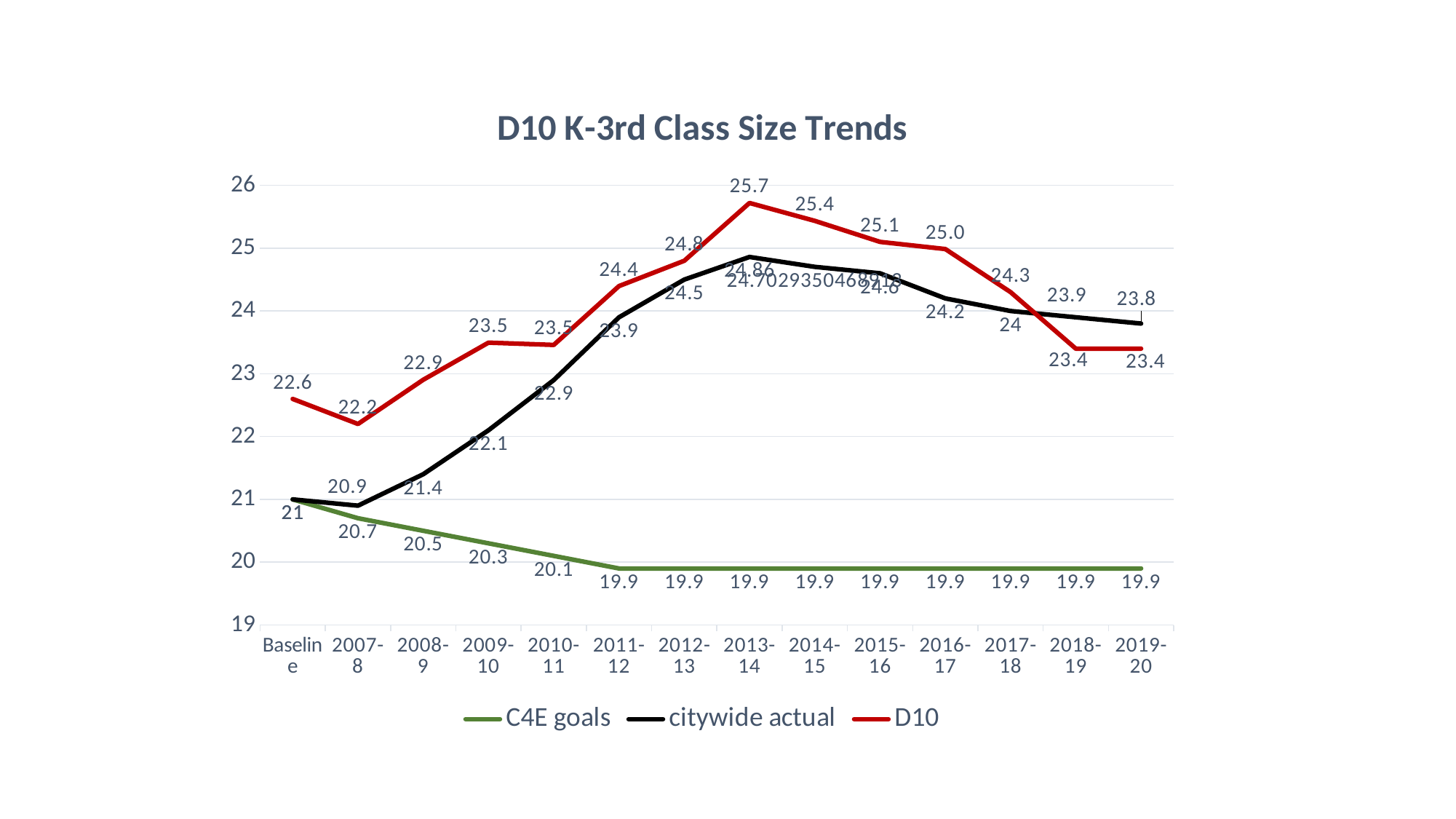
How many series does the legend list? 3 In which year is the D10 value highest? 2013-14 What is the difference between the D10 value in 2013-14 and in 2007-8? 3.5 What is the citywide actual value for 2011-12? 23.9 How many categories are shown along the x axis? 14 What is the D10 value for 2013-14? 25.7 What kind of chart is shown on the slide? line chart In 2019-20, which is larger: the D10 value or the citywide actual value? citywide actual In which year is the D10 value lowest? 2007-8 Do the C4E goals values rise or fall from Baseline to 2011-12? fall Is the D10 value for 2016-17 greater or less than 24? greater What is the C4E goals value for 2019-20? 19.9